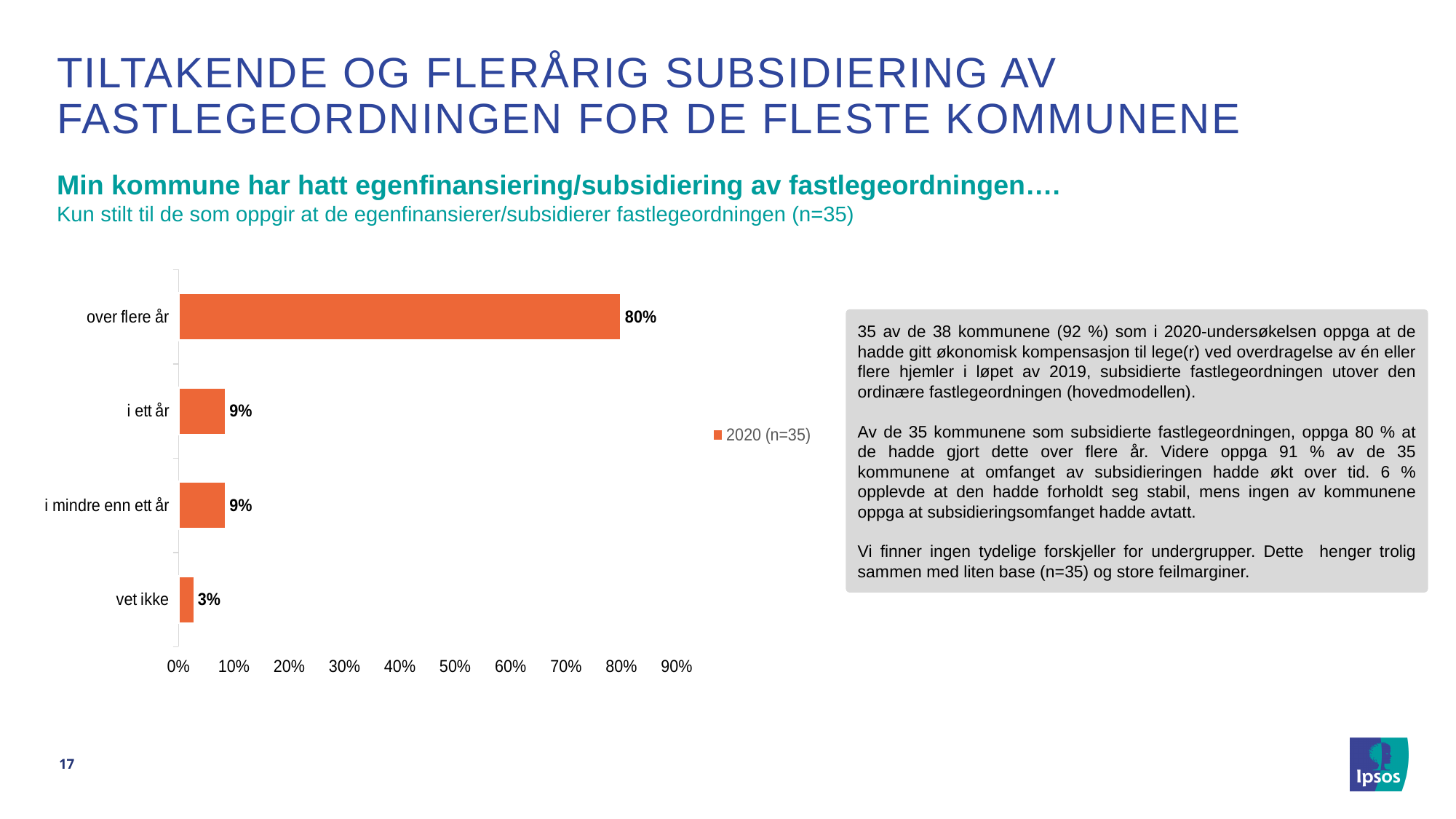
What is the difference between the values for "over flere år" and "i ett år"? 71% What is the value for "vet ikke"? 3% What is the value for "i ett år"? 9% How many categories are shown in the chart? 4 Which category has the lowest value? vet ikke Which is larger, the value for "over flere år" or the value for "i mindre enn ett år"? over flere år What is the value for "over flere år"? 80% Is the value for "over flere år" greater or less than 70%? greater How many series does the legend list? 1 What kind of chart is shown on the slide? bar chart What is the difference between the values for "i mindre enn ett år" and "vet ikke"? 6% Which category has the highest value? over flere år